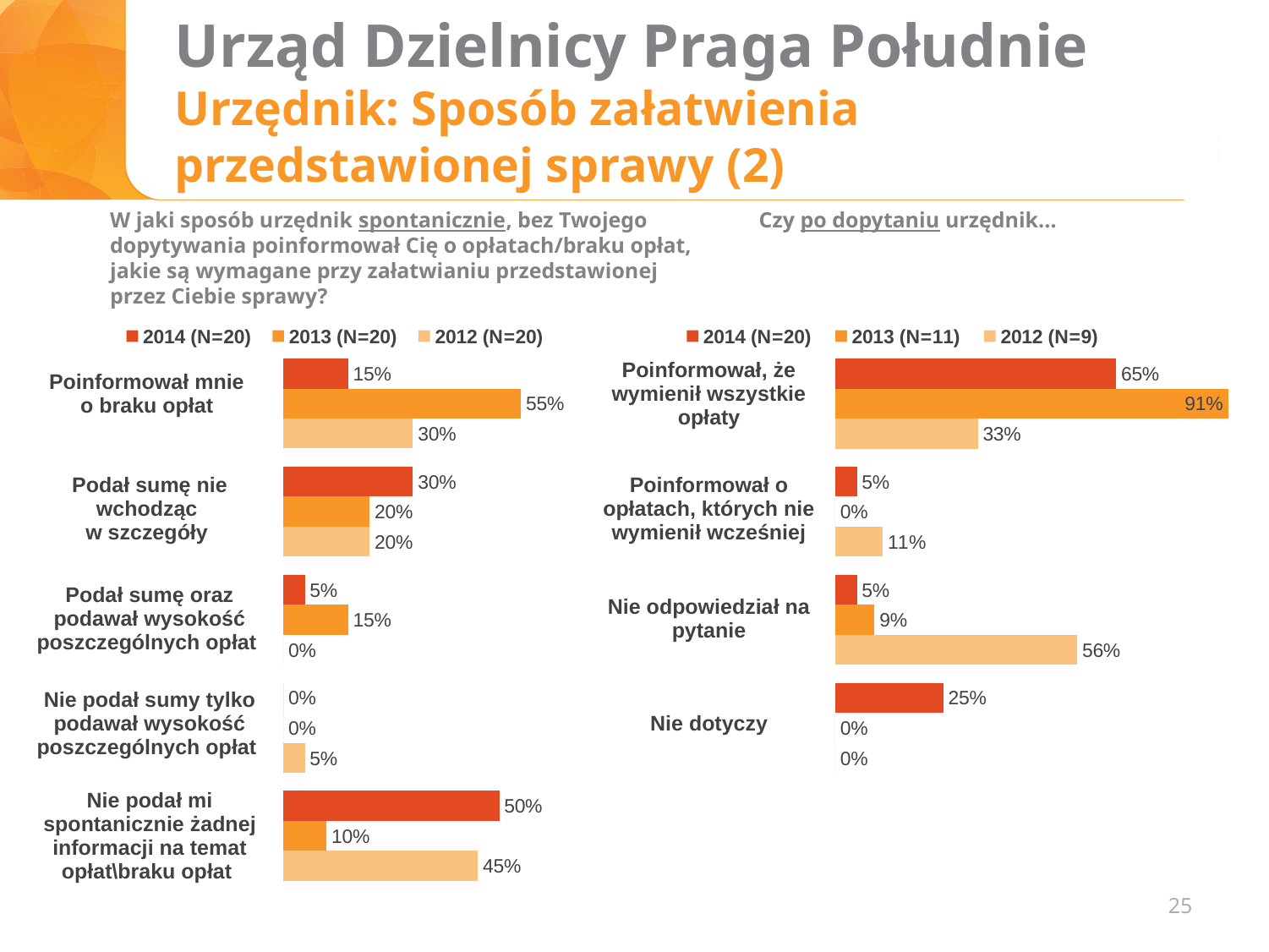
In the right chart ("Czy po dopytaniu urzędnik..."), what is the difference between the 2013 and 2012 values for "Poinformował, że wymienił wszystkie opłaty"? 58 percentage points How many series does the legend of the right chart ("Czy po dopytaniu urzędnik...") list? 3 In the left chart (spontaneous information about fees), which category has the highest 2014 value? Nie podał mi spontanicznie żadnej informacji na temat opłat\braku opłat In the left chart (spontaneous information about fees), which is larger for "Podał sumę nie wchodząc w szczegóły": the 2014 value or the 2013 value? 2014 What type of chart is the right chart ("Czy po dopytaniu urzędnik...")? Bar chart In the right chart ("Czy po dopytaniu urzędnik..."), what is the 2012 value for "Nie odpowiedział na pytanie"? 56% How many categories does the left chart (spontaneous information about fees) show? 5 In the left chart (spontaneous information about fees), what is the difference between the 2013 and 2014 values for "Poinformował mnie o braku opłat"? 40 percentage points In the left chart (spontaneous information about fees), what is the 2014 value for "Nie podał mi spontanicznie żadnej informacji na temat opłat\braku opłat"? 50% In the left chart (spontaneous information about fees), what is the 2013 value for "Poinformował mnie o braku opłat"? 55% In the right chart ("Czy po dopytaniu urzędnik..."), what is the 2013 value for "Poinformował, że wymienił wszystkie opłaty"? 91%